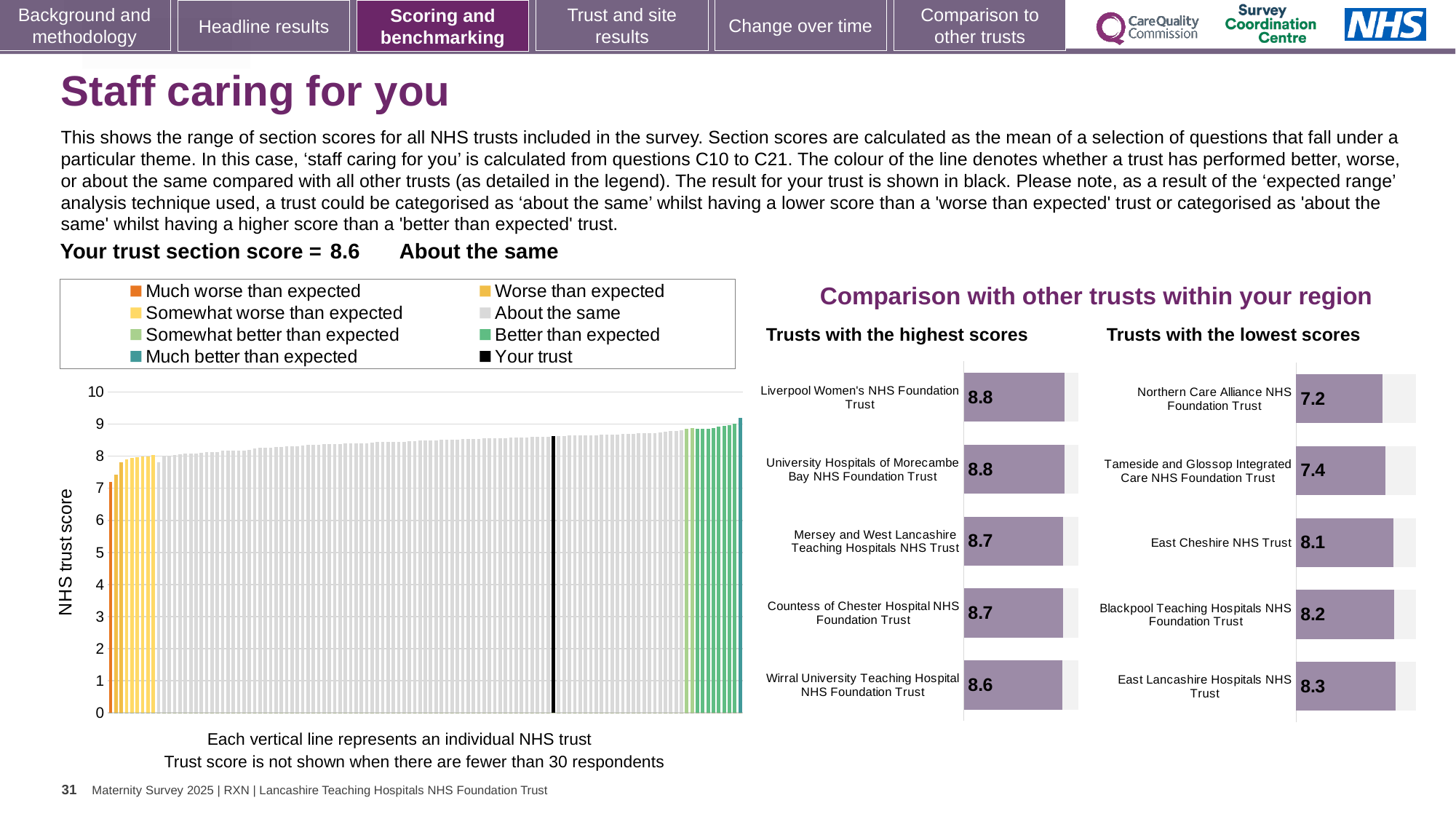
What kind of chart is the large 'NHS trust score' chart on the left of the slide? Bar chart In the 'Trusts with the lowest scores' chart, what is the score for Northern Care Alliance NHS Foundation Trust? 7.2 How many trusts are listed in the 'Trusts with the highest scores' chart? 5 In the 'Trusts with the lowest scores' chart, what is the difference between the scores of East Lancashire Hospitals NHS Trust and Northern Care Alliance NHS Foundation Trust? 1.1 What is the section score for your trust shown on the slide? 8.6 In the 'Trusts with the highest scores' chart, what is the score for Wirral University Teaching Hospital NHS Foundation Trust? 8.6 In the 'Trusts with the lowest scores' chart, what is the score for East Cheshire NHS Trust? 8.1 In the 'NHS trust score' chart, is the value for the black 'Your trust' bar greater or less than 8? greater In the 'Trusts with the lowest scores' chart, which has the higher score: Tameside and Glossop Integrated Care NHS Foundation Trust or Blackpool Teaching Hospitals NHS Foundation Trust? Blackpool Teaching Hospitals NHS Foundation Trust In the 'Trusts with the highest scores' chart, what is the score for Liverpool Women's NHS Foundation Trust? 8.8 In the 'Trusts with the lowest scores' chart, which trust has the lowest score? Northern Care Alliance NHS Foundation Trust How many entries does the legend above the 'NHS trust score' chart list? 8